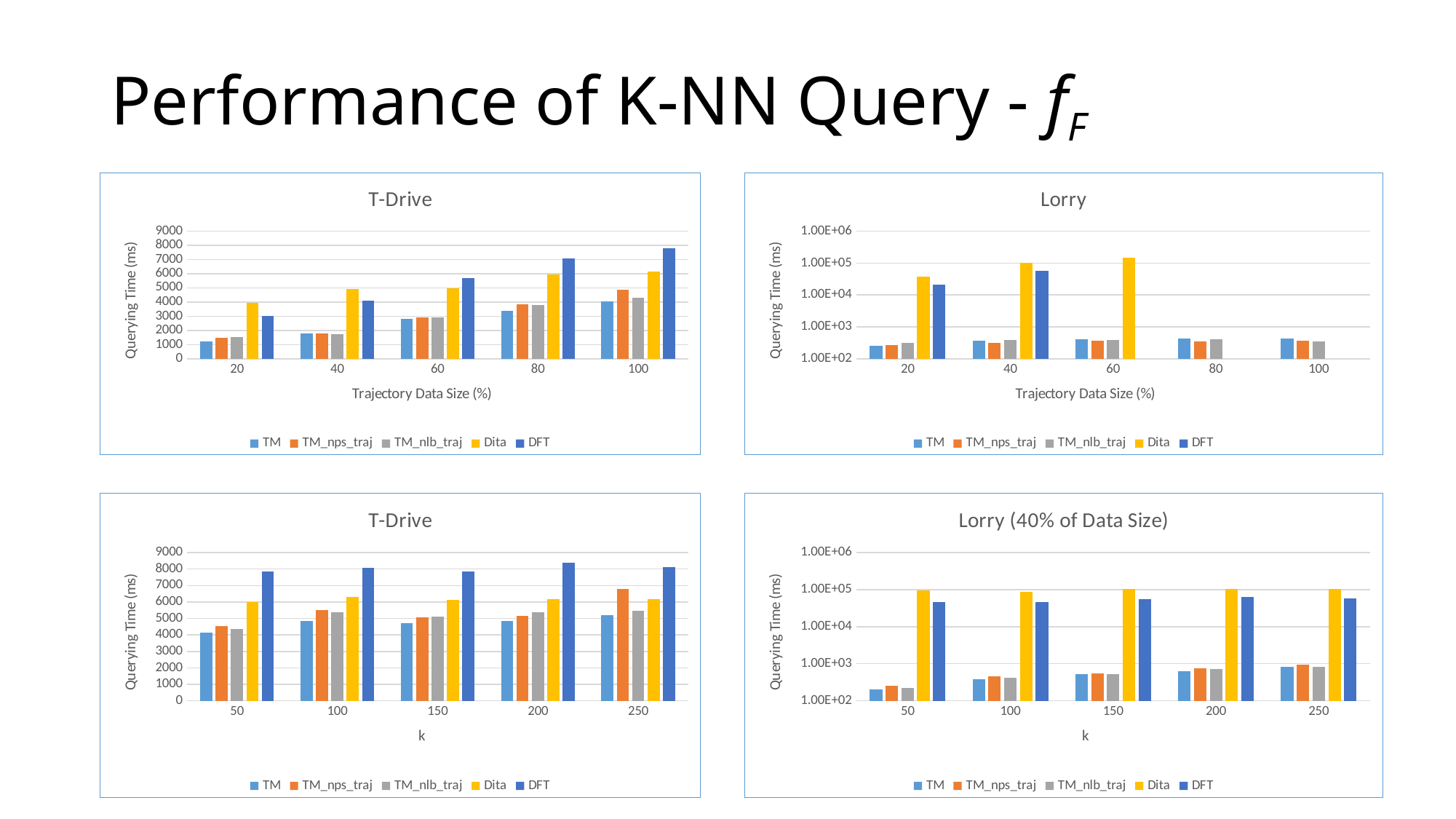
How many k categories are shown on the x axis of the bottom-left T-Drive chart? 5 In the bottom-left T-Drive chart, which is larger at k = 250, TM_nps_traj or Dita? TM_nps_traj What kind of chart is the bottom-right Lorry (40% of Data Size) chart? bar chart In the top-left T-Drive chart, is the value for DFT at trajectory data size 100 greater or less than 7000? greater In the top-left T-Drive chart, is the value for TM at trajectory data size 20 greater or less than 2000? less In the top-right Lorry chart, is the value for DFT at trajectory data size 20 greater or less than 1.00E+04? greater How many series does the legend of the top-right Lorry chart list? 5 In the top-left T-Drive chart, which series has the highest value at trajectory data size 100? DFT In the top-left T-Drive chart, do the TM values rise or fall as trajectory data size increases from 20 to 100? rise